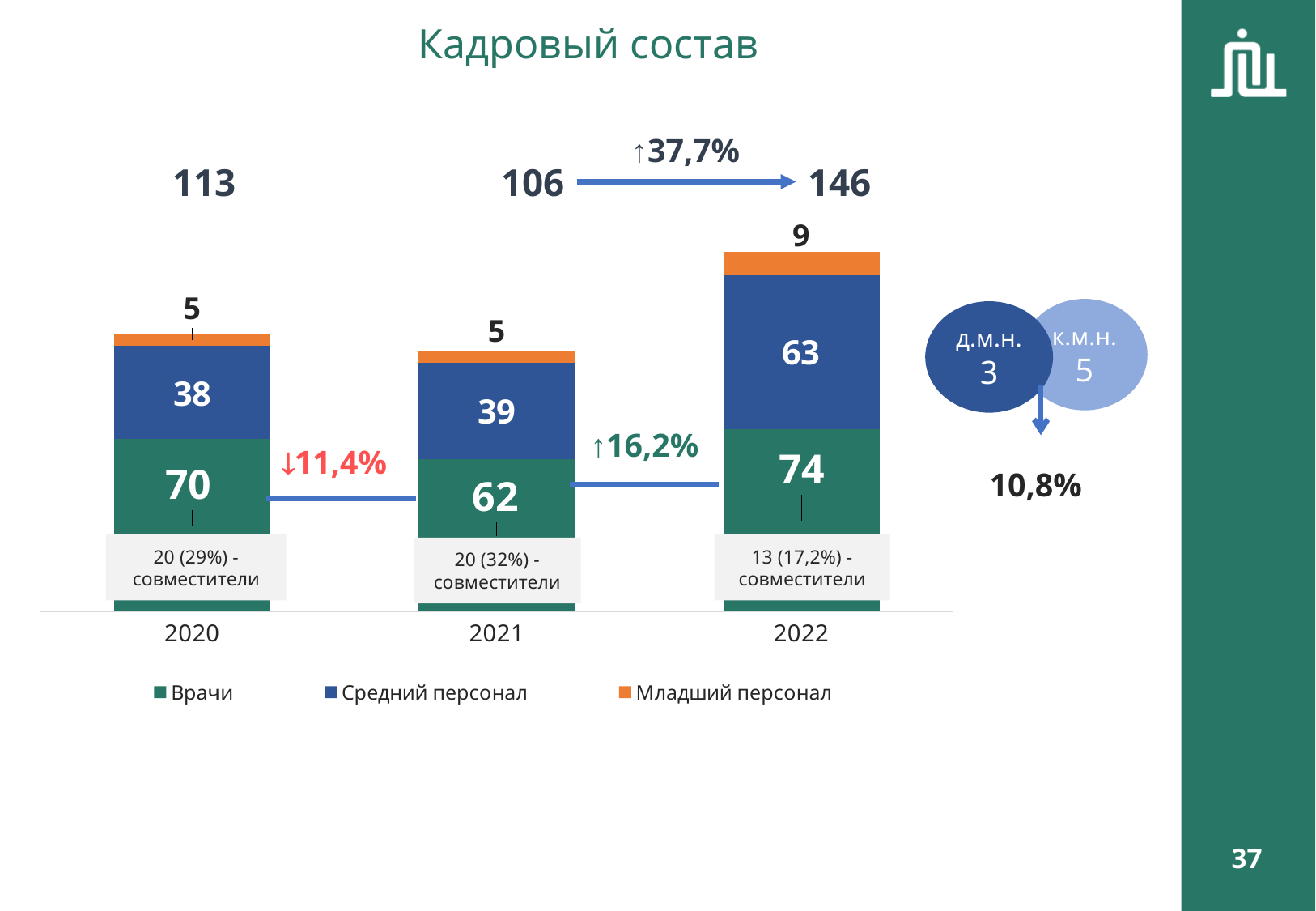
What is the value for Врачи in 2022? 74 In which year is the value for Средний персонал the highest? 2022 What is the total of the stacked bar for 2020? 113 How many series does the legend list? 3 Which colour represents Младший персонал in the legend? orange What is the difference between the Средний персонал values for 2022 and 2021? 24 Which is larger: Врачи in 2020 or Врачи in 2022? Врачи in 2022 What is the value for Средний персонал in 2021? 39 What type of chart is shown on the slide? stacked bar chart How many years (categories) are shown on the x axis? 3 In which year is the value for Врачи the lowest? 2021 What is the value for Младший персонал in 2022? 9